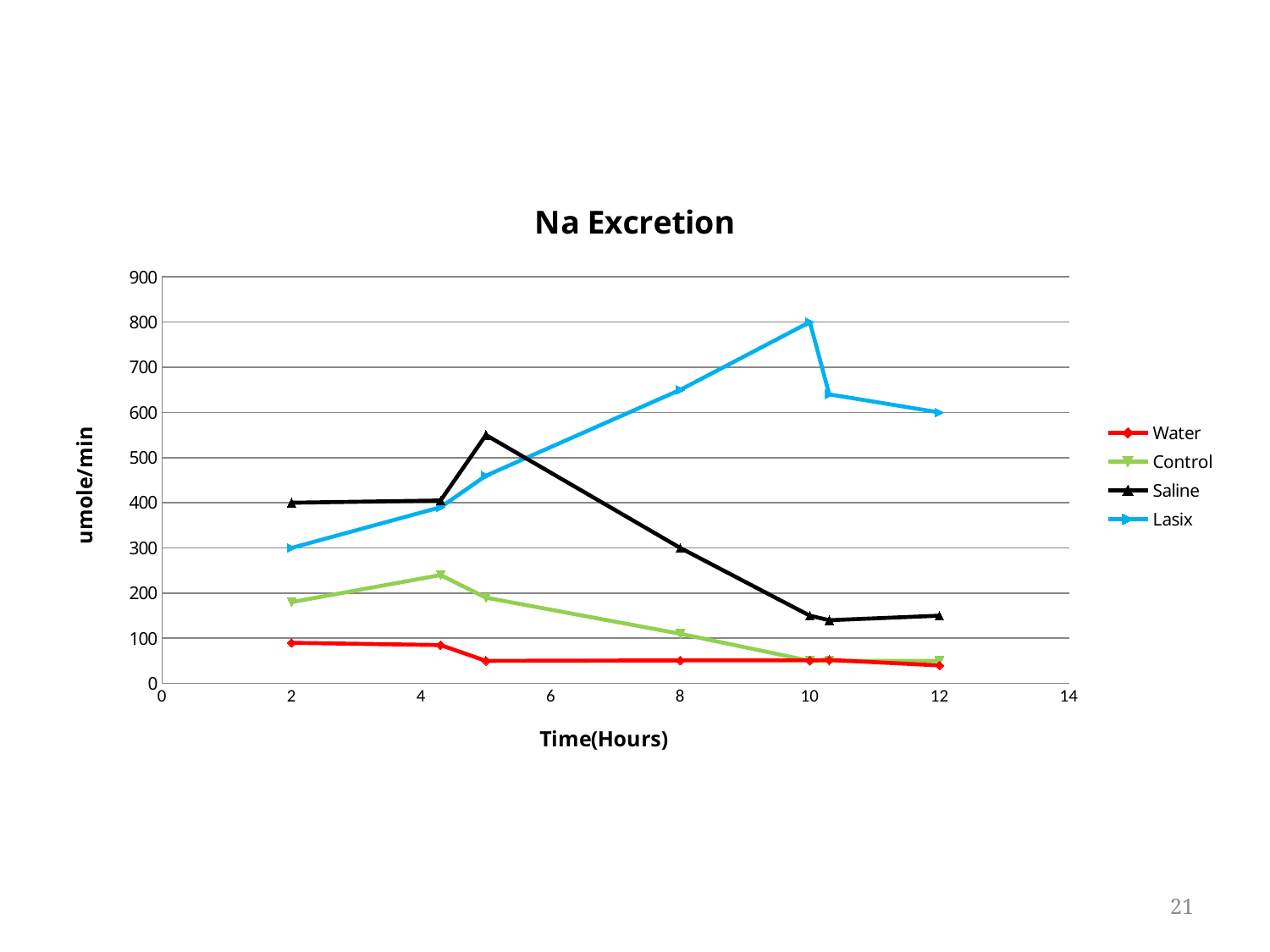
What is the label of the y axis? umole/min Does the Lasix series rise or fall between 2 and 10 hours? rise Is the Saline value at 5 hours greater or less than 500? greater What kind of chart is shown on the slide? line chart What is the Lasix value at 10 hours? 800 At 8 hours, which is larger, Saline or Lasix? Lasix Which series reaches the highest value on the chart? Lasix How many series does the legend list? 4 What is the Lasix value at 2 hours? 300 What is the title of the chart? Na Excretion Which series has the lowest values across the chart? Water What is the Saline value at 2 hours? 400